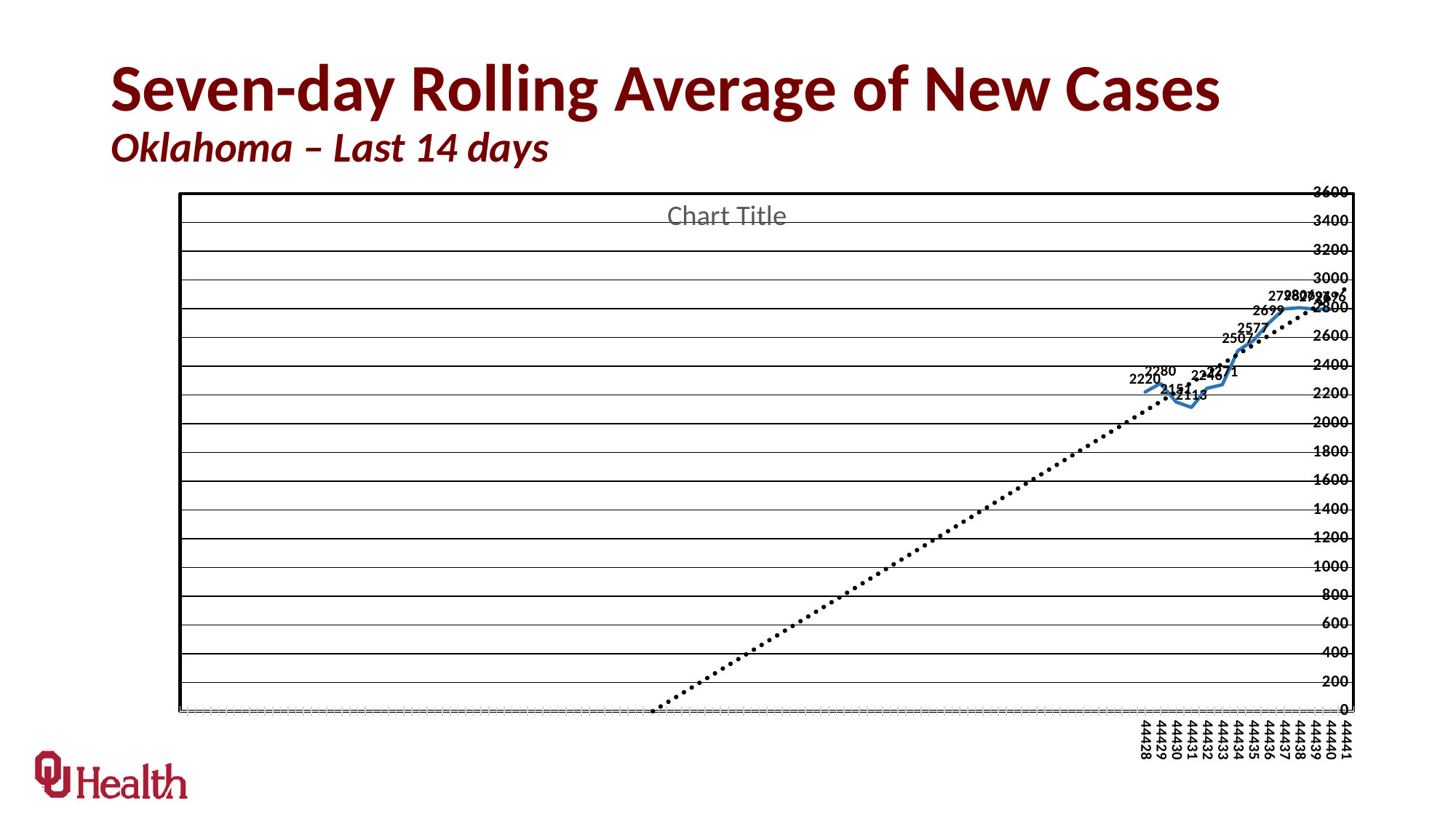
Is the value for 44431 greater or less than 2200? less Is the value for the last point (44441) greater or less than 2600? greater What is the highest tick value shown on the y axis? 3600 Overall, do the values rise or fall from left to right along the x axis? rise What kind of chart is shown on the slide? line chart Which is larger, the value labelled 2220 or the value labelled 2113? 2220 What title text is displayed inside the chart area? Chart Title What is the lowest labelled value on the line? 2113 What is the value of the first plotted point (at 44428)? 2220 What is the difference between the values labelled 2280 and 2220? 60